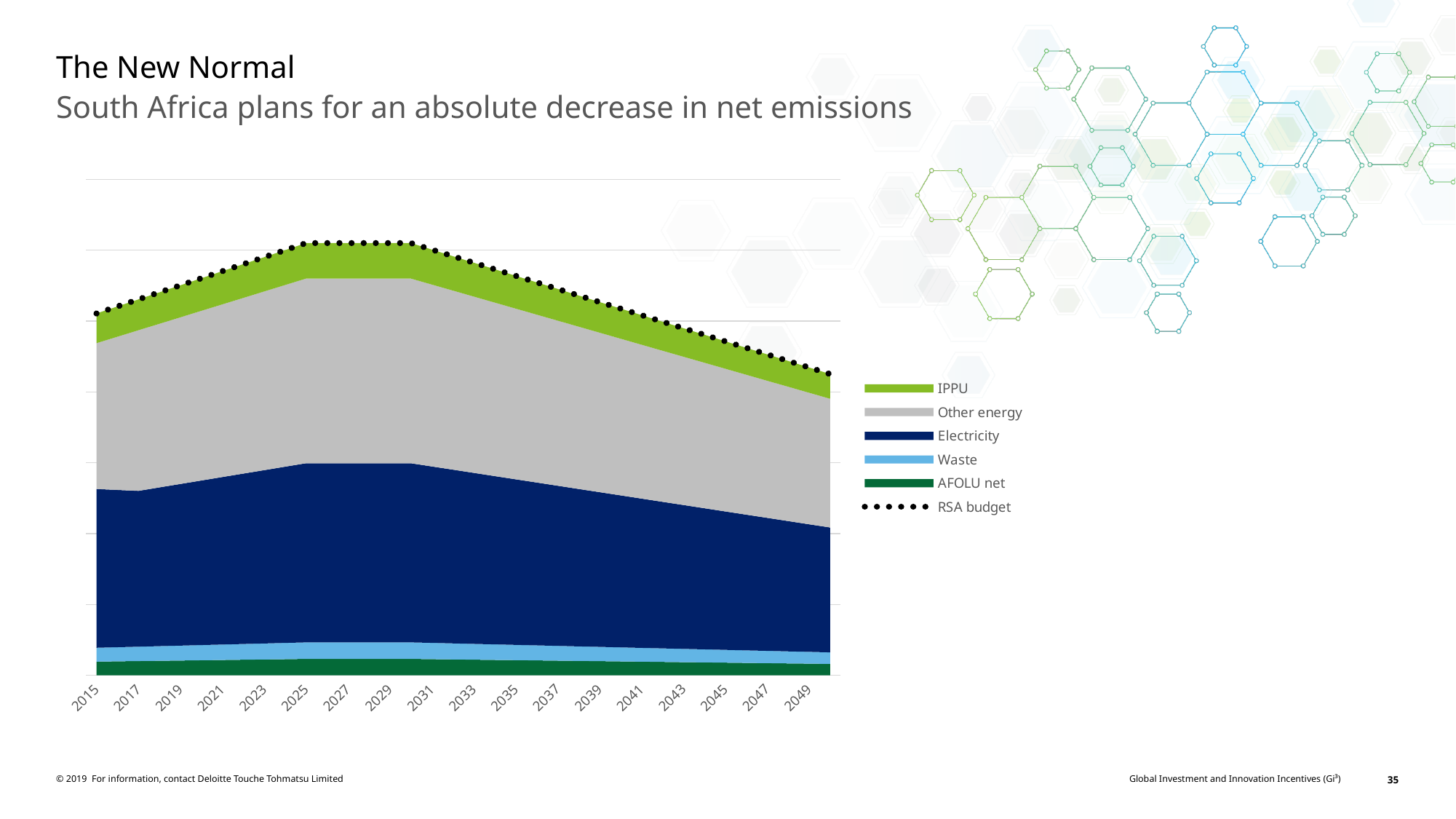
How many series does the legend list? 6 What kind of chart is shown on the slide? Stacked area chart with a dotted line series How many year labels are shown on the x axis? 18 Which series is shown with a dotted black line? RSA budget Does the total stacked emissions area rise or fall from 2031 to 2049? Fall Does the RSA budget line rise or fall between 2029 and 2049? Fall What is the last year shown on the x axis? 2049 Which is larger in 2049, the Other energy band or the IPPU band? Other energy Which is larger in 2035, the Electricity band or the Waste band? Electricity What is the first year shown on the x axis? 2015 Does the RSA budget line rise or fall between 2015 and 2025? Rise